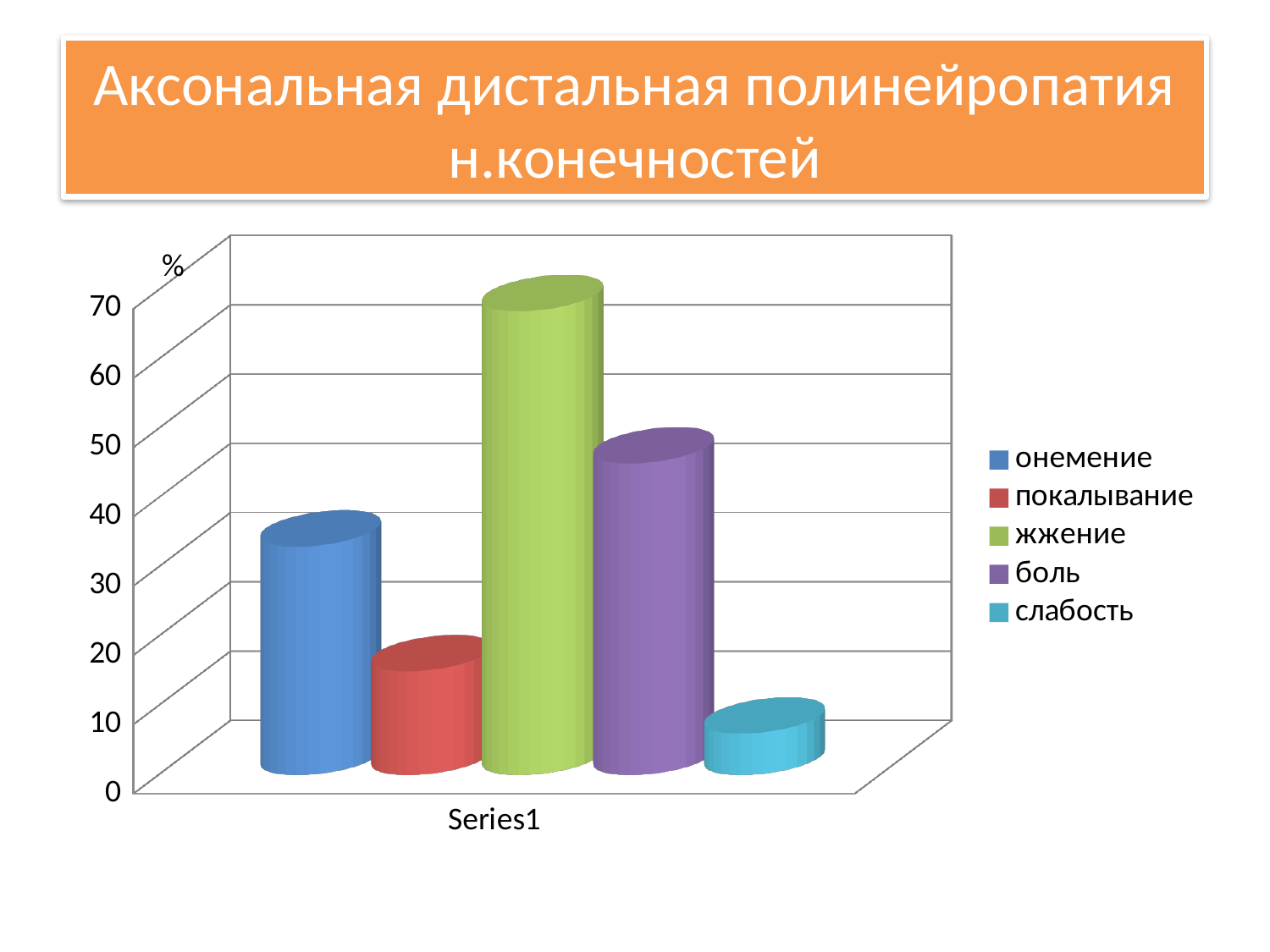
Is the value for боль greater or less than 40? greater How many bars are plotted in the chart? 5 Is the value for слабость greater or less than 10? less Which is larger, the value for покалывание or the value for слабость? покалывание Which symptom has the lowest value in the chart? слабость What kind of chart is shown on the slide? bar chart Which symptom has the highest value in the chart? жжение Is the value for покалывание greater or less than 20? less What unit label is shown at the top of the vertical axis? % Which is larger, the value for боль or the value for онемение? боль How many entries does the legend list? 5